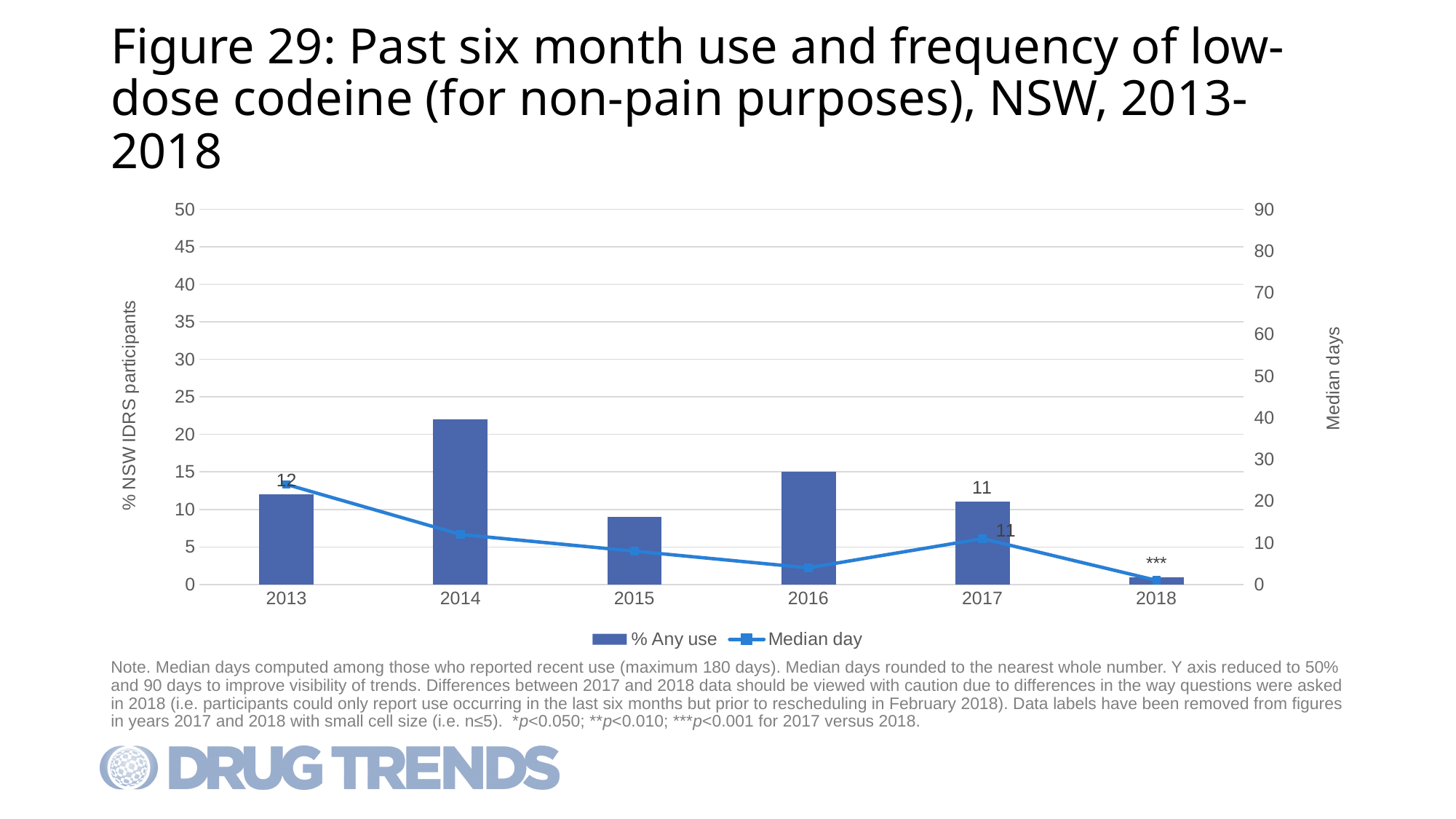
What is the % Any use value for 2017? 11 Is the % Any use value for 2014 greater or less than 20? greater How many series does the legend list? 2 Which year has the highest % Any use bar? 2014 What is the difference between the % Any use values for 2013 and 2017? 1 What is the Median day value for 2017? 11 What is the % Any use value for 2013? 12 Which year has the lowest % Any use bar? 2018 Which year has the larger % Any use bar, 2014 or 2016? 2014 Which year has the highest Median day value? 2013 How many years are shown on the x axis? 6 What kind of chart is shown on the slide? A combined bar and line chart